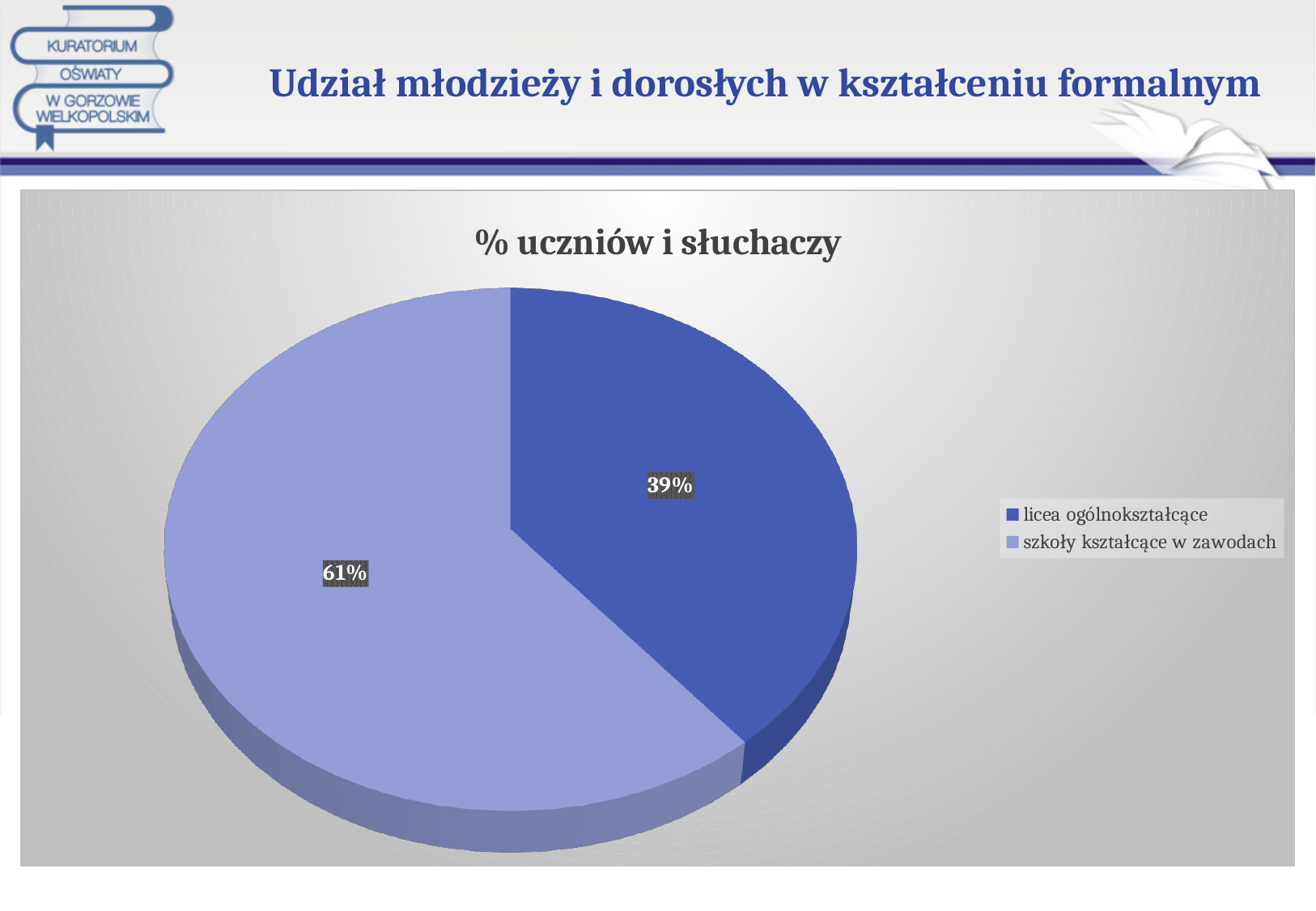
What is the chart's title? % uczniów i słuchaczy What share of the pie is 'szkoły kształcące w zawodach'? 61% How many entries does the legend list? 2 Which is larger: the slice for 'licea ogólnokształcące' or the slice for 'szkoły kształcące w zawodach'? szkoły kształcące w zawodach What share of the pie is 'licea ogólnokształcące'? 39% What kind of chart is shown on the slide? pie chart What is the difference in percentage points between 'szkoły kształcące w zawodach' and 'licea ogólnokształcące'? 22 Which category has the smallest slice of the pie? licea ogólnokształcące How many slices does the pie chart have? 2 Which legend entry is shown in the darker blue colour? licea ogólnokształcące Which category has the largest slice of the pie? szkoły kształcące w zawodach